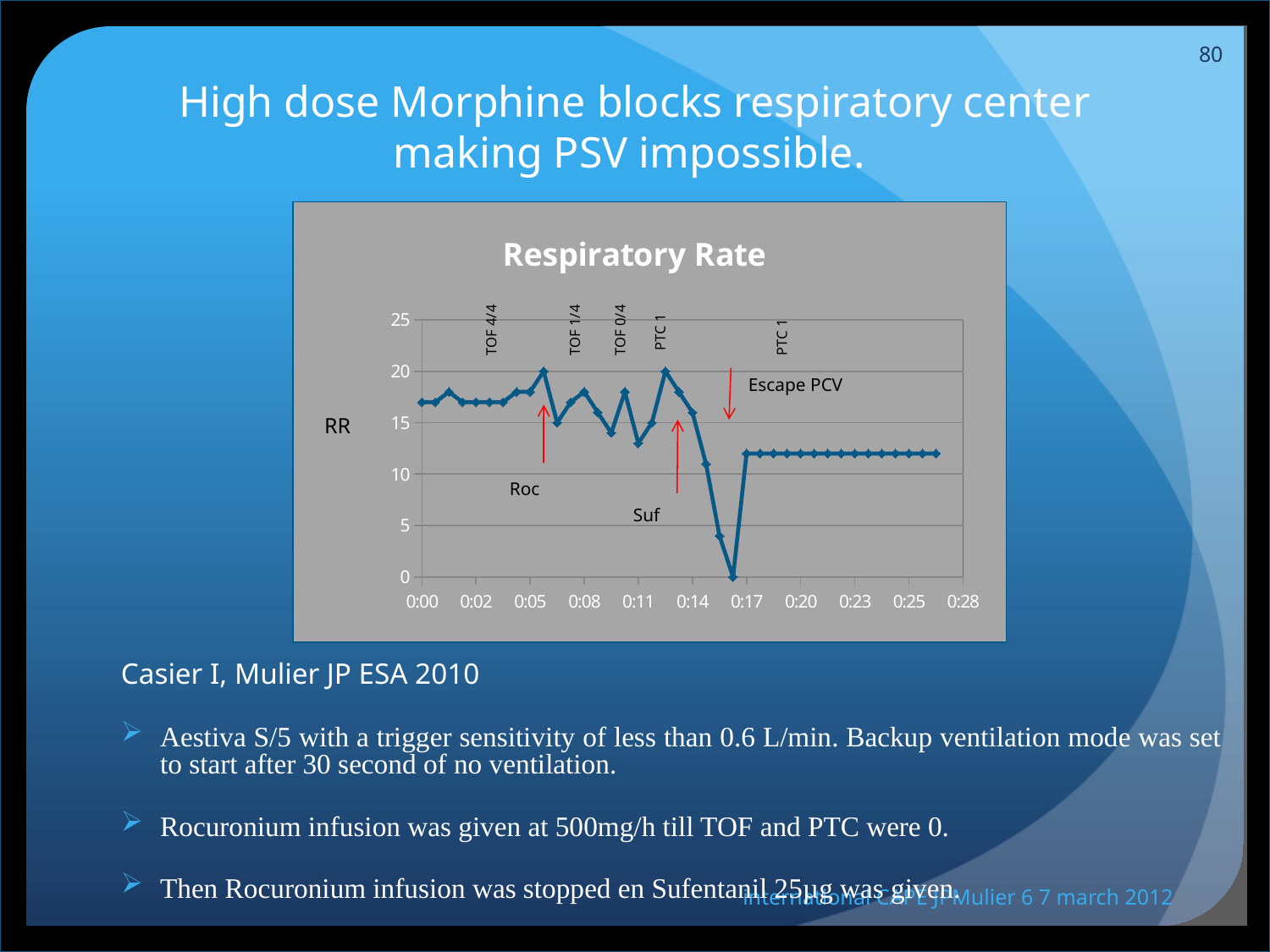
What is the title of the chart? Respiratory Rate Does the respiratory rate rise or fall between 0:13 and 0:16? fall Is the respiratory rate at 0:25 greater or less than 10? greater What is the highest respiratory rate value reached on the chart? 20 Is the respiratory rate at 0:02 greater or less than 10? greater Is the respiratory rate at 0:20 greater or less than 15? less What is the lowest respiratory rate value reached on the chart? 0 What label is shown on the vertical axis of the chart? RR What kind of chart is shown on the slide? line chart How many time labels are shown along the x axis of the chart? 11 Does the respiratory rate rise, fall or stay flat between 0:17 and 0:26? stays flat